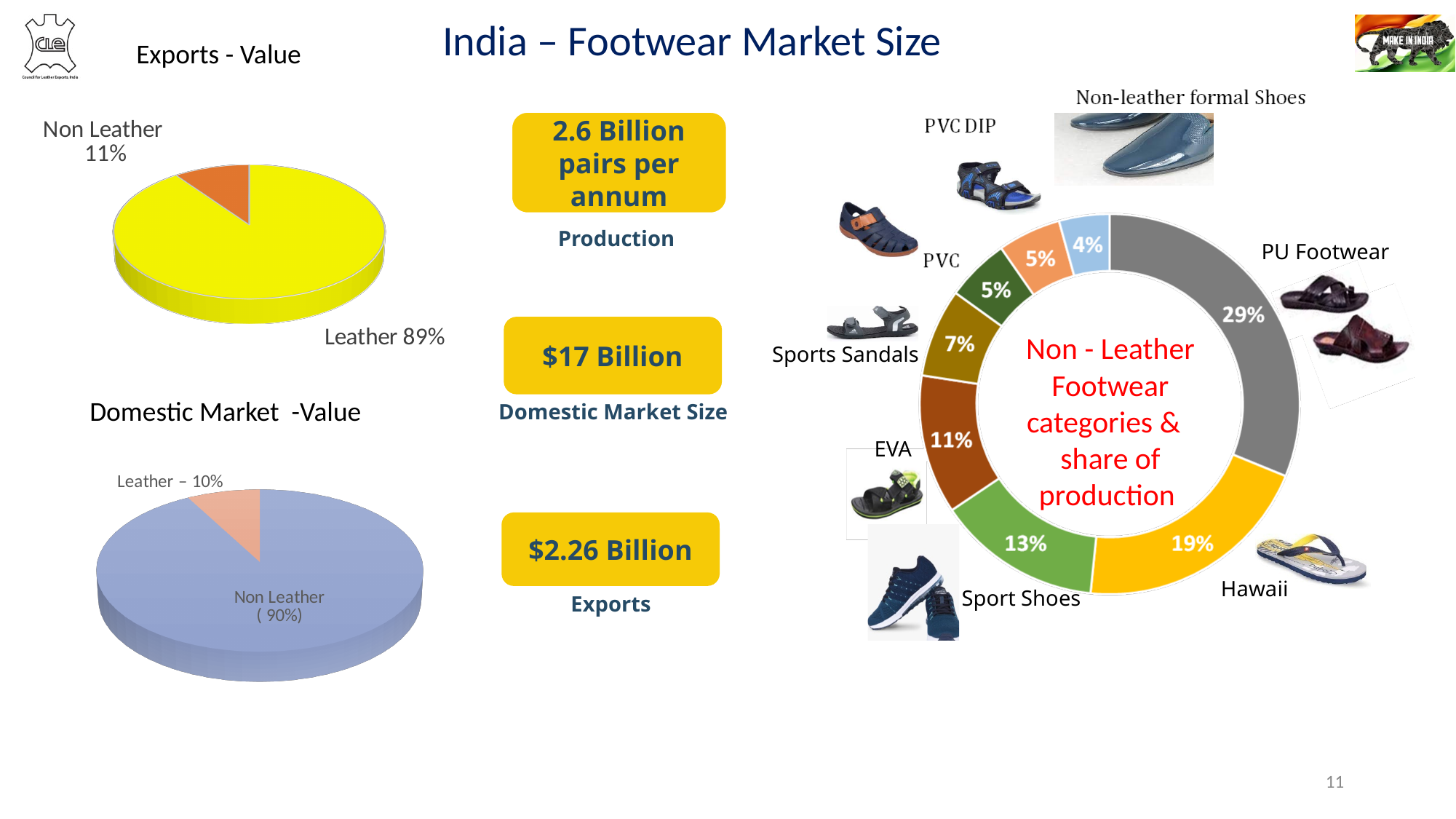
In the Domestic Market - Value pie chart, what share does Leather have? 10% In the Exports - Value pie chart, what share does Leather have? 89% In the Exports - Value pie chart, what share does Non Leather have? 11% In the Non-Leather Footwear categories donut chart, what share of production does PU Footwear have? 29% In the Non-Leather Footwear categories donut chart, what share of production does Hawaii have? 19% In the Non-Leather Footwear categories donut chart, what is the difference between the Sport Shoes and EVA shares? 2% In the Exports - Value pie chart, what is the difference between the Leather and Non Leather shares? 78% In the Exports - Value pie chart, which category has the larger share, Leather or Non Leather? Leather In the Non-Leather Footwear categories donut chart, which category has the largest share of production? PU Footwear In the Domestic Market - Value pie chart, what share does Non Leather have? 90% What kind of chart is the Exports - Value chart? Pie chart How many categories are shown in the Non-Leather Footwear categories donut chart? 8